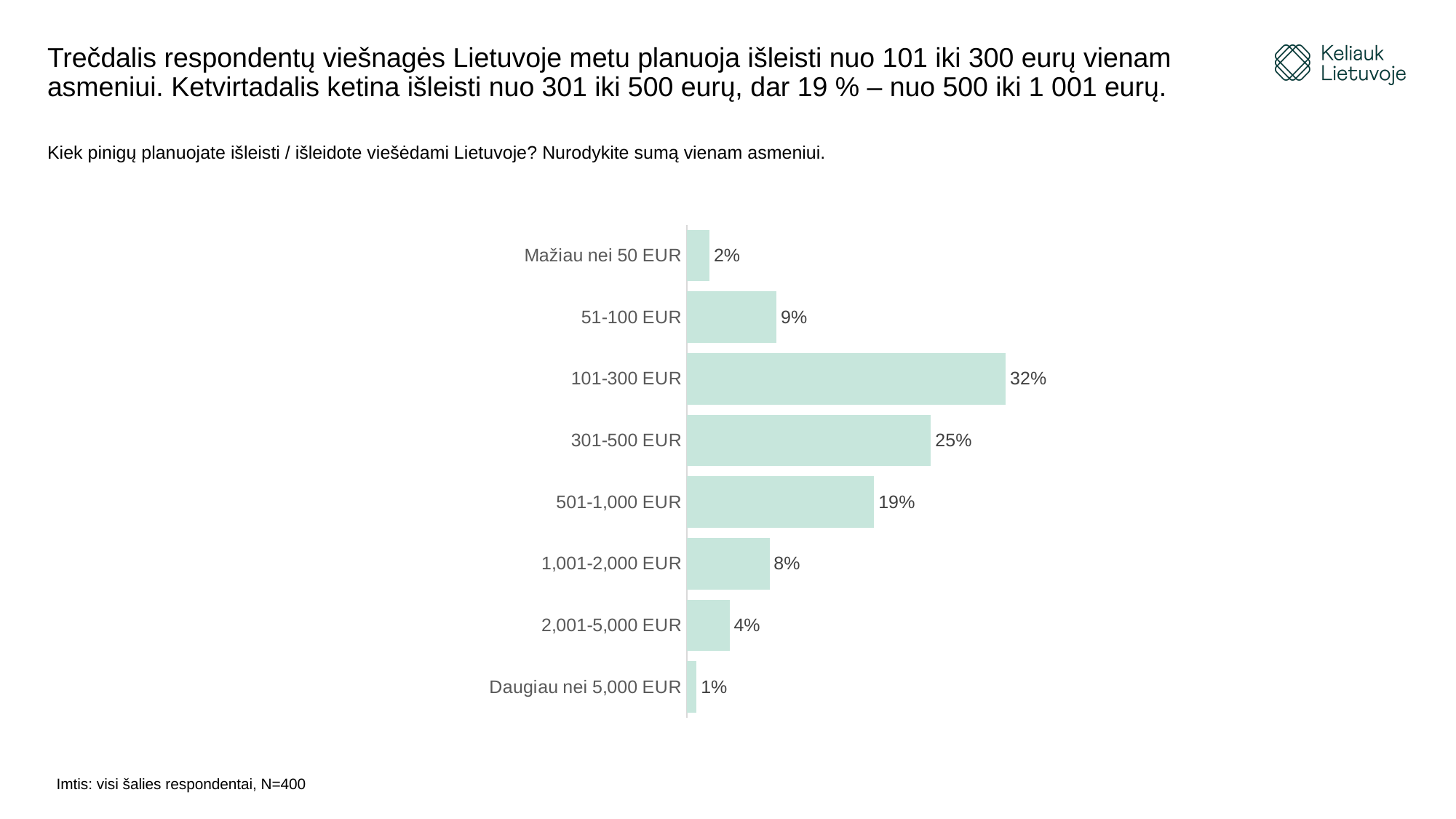
What is the combined value of the 2,001-5,000 EUR and 'Daugiau nei 5,000 EUR' categories? 5% What is the value for the 501-1,000 EUR category? 19% How many spending categories are shown in the chart? 8 Which is larger: the value for 301-500 EUR or for 501-1,000 EUR? 301-500 EUR What is the sample size stated at the bottom of the slide? N=400 What kind of chart is shown on the slide? Bar chart What percentage is shown for 'Mažiau nei 50 EUR'? 2% What is the difference between the 51-100 EUR and 1,001-2,000 EUR values? 1% Which spending category has the lowest share of respondents? Daugiau nei 5,000 EUR What is the difference between the 101-300 EUR and 301-500 EUR values? 7% What percentage of respondents plan to spend 101-300 EUR per person? 32% Which spending category has the highest share of respondents? 101-300 EUR